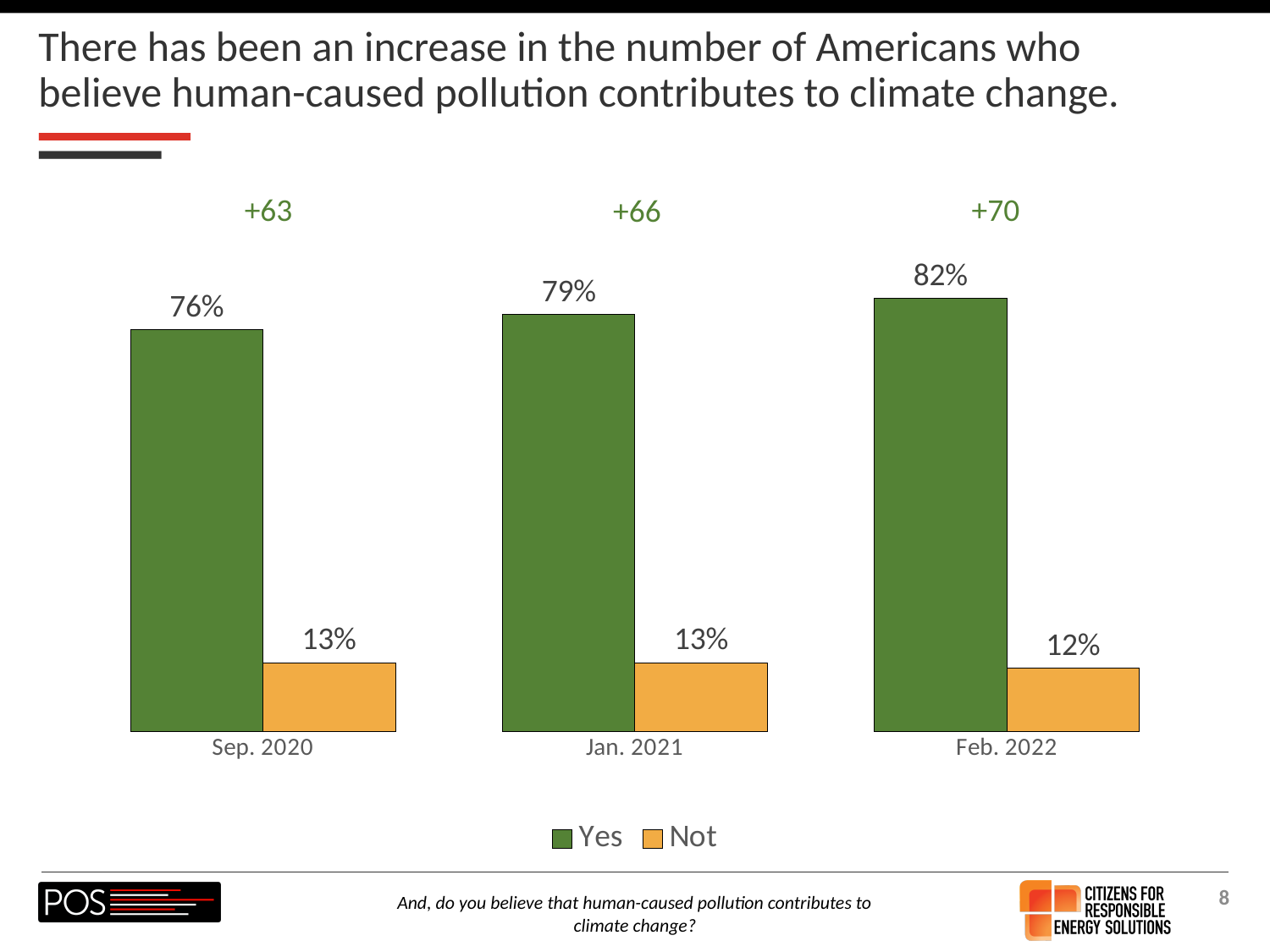
What percentage answered Yes in Jan. 2021? 79% How many time periods are shown on the x axis? 3 In which period was the Yes value highest? Feb. 2022 In which period was the Not value lowest? Feb. 2022 Does the Yes value rise or fall from Sep. 2020 to Feb. 2022? Rise How many series does the legend list? 2 What percentage answered Yes in Sep. 2020? 76% What percentage answered Not in Feb. 2022? 12% What kind of chart is shown on the slide? Bar chart Which is larger: the Yes value in Jan. 2021 or the Yes value in Sep. 2020? Jan. 2021 By how many percentage points did the Yes value increase from Sep. 2020 to Feb. 2022? 6 What is the difference between the Yes and Not values in Feb. 2022? 70